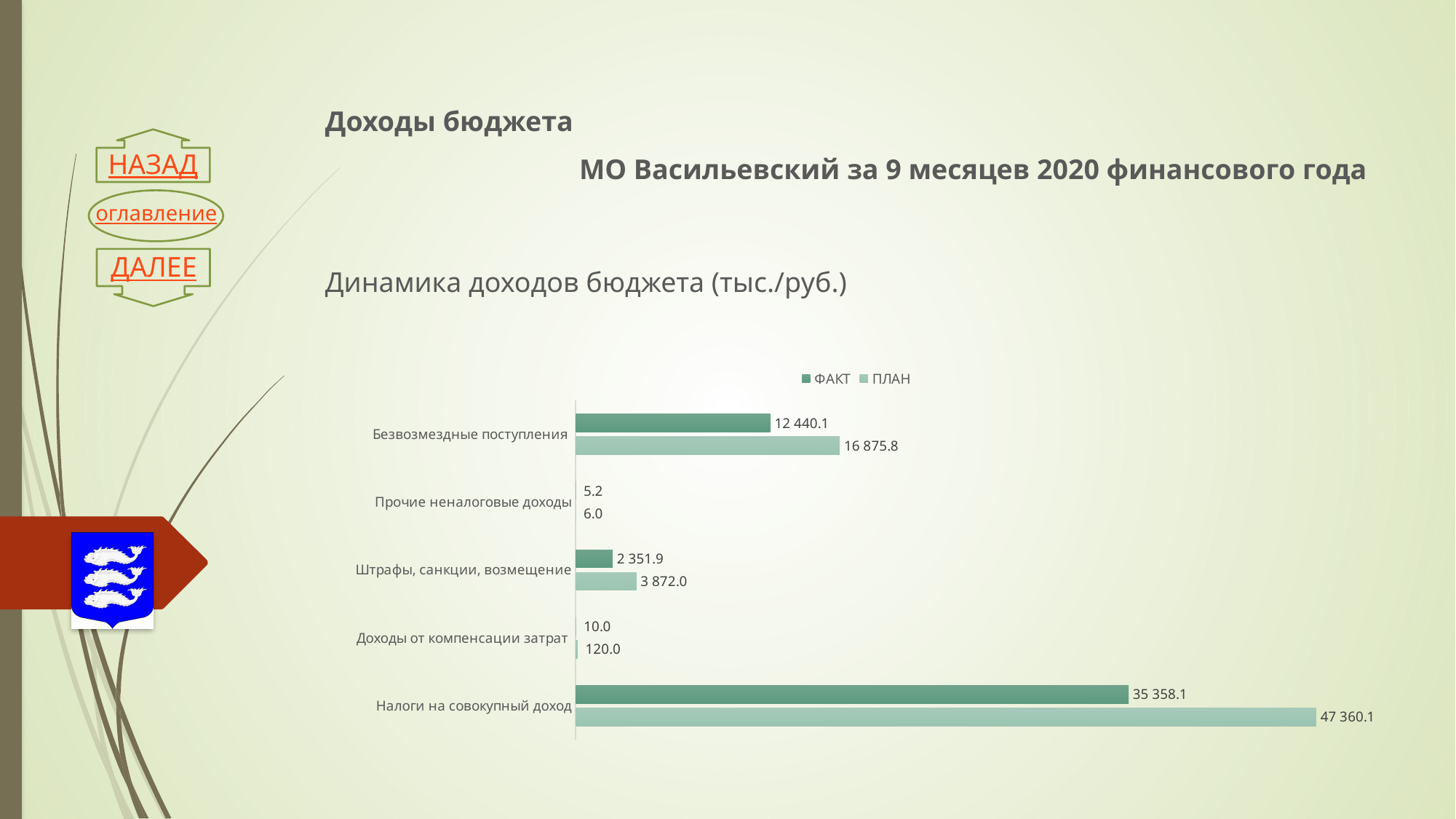
What is the difference between the ПЛАН and ФАКТ values for Налоги на совокупный доход? 12 002.0 What is the ПЛАН value for Доходы от компенсации затрат? 120.0 What is the ФАКТ value for Прочие неналоговые доходы? 5.2 What are the two series named in the legend? ФАКТ and ПЛАН How many categories are shown on the chart? 5 What is the ФАКТ value for Налоги на совокупный доход? 35 358.1 How many series does the legend list? 2 Which category has the lowest ФАКТ value? Прочие неналоговые доходы Which is larger for Штрафы, санкции, возмещение: the ФАКТ value or the ПЛАН value? ПЛАН What is the ПЛАН value for Безвозмездные поступления? 16 875.8 What type of chart is shown on the slide? bar chart Which category has the highest ПЛАН value? Налоги на совокупный доход